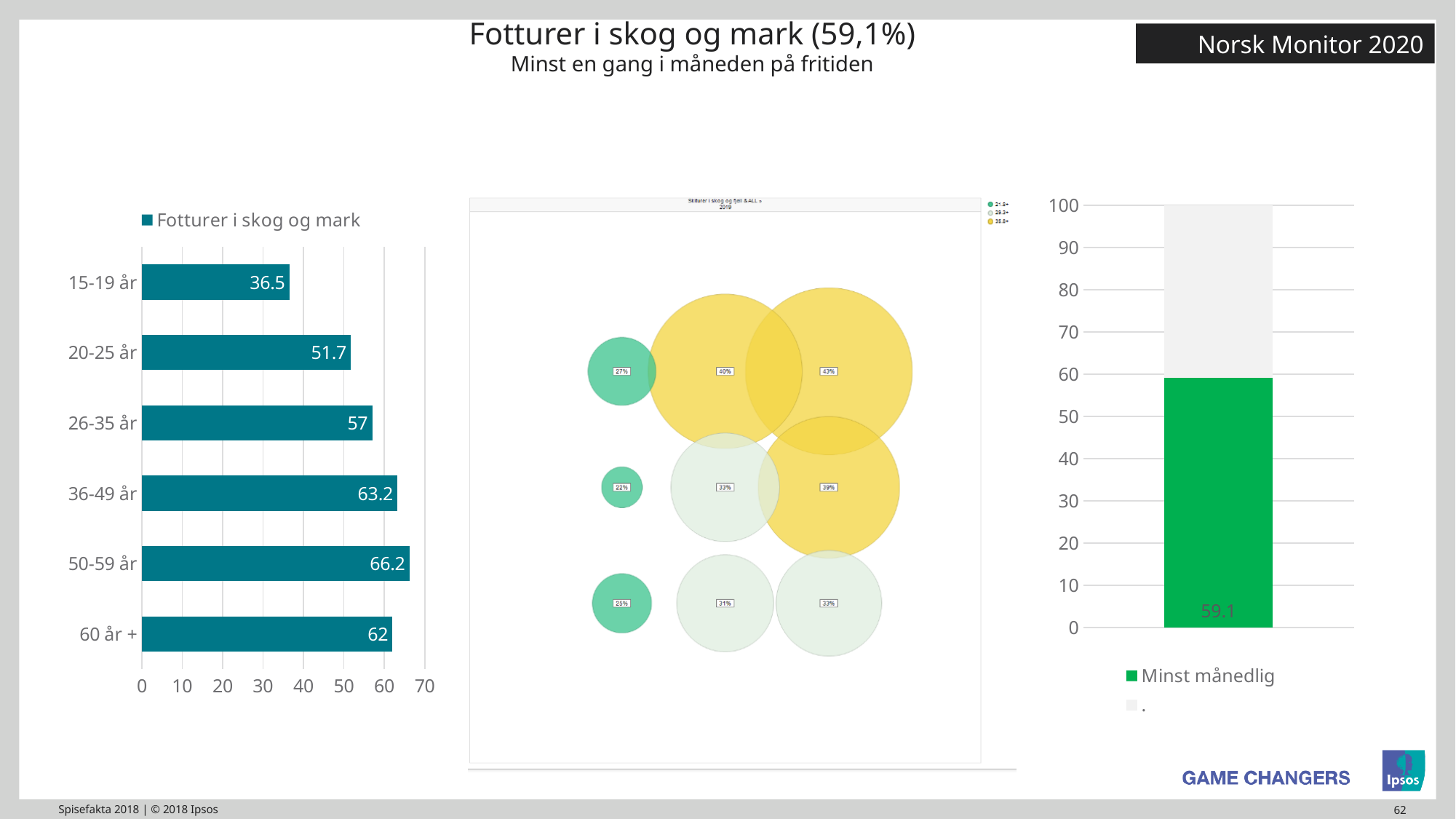
In the left bar chart, what is the value for the 60 år + age group? 62 In the left bar chart, what is the difference between the values for 36-49 år and 26-35 år? 6.2 In the left bar chart, what is the value for the 50-59 år age group? 66.2 What is the legend entry shown above the left bar chart? Fotturer i skog og mark In the left bar chart, which age group has the lowest value? 15-19 år In the right-hand chart, is the value of the 'Minst månedlig' bar greater or less than 50? greater In the right-hand chart, what is the value of the green 'Minst månedlig' bar? 59.1 In the left bar chart, which is larger: the value for 20-25 år or the value for 60 år +? 60 år + In the left bar chart, which age group has the highest value? 50-59 år What kind of chart is the chart on the left of the slide? Bar chart In the left bar chart, what is the value for the 15-19 år age group? 36.5 How many age groups are shown in the left bar chart? 6